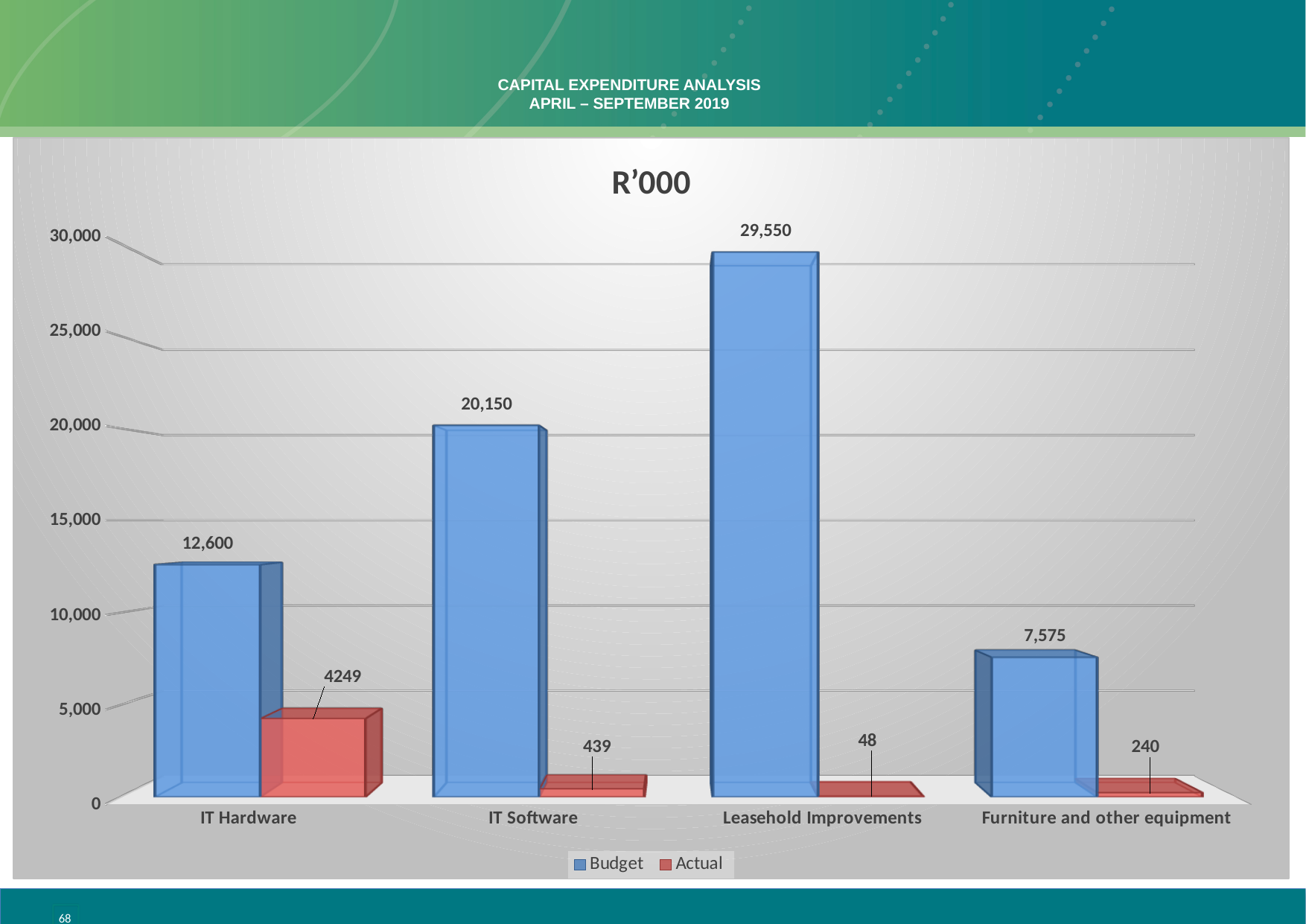
What is the Budget value for Leasehold Improvements? 29,550 Which is larger, the Budget value for IT Software or the Budget value for IT Hardware? IT Software What is the Budget value for Furniture and other equipment? 7,575 Which category has the lowest Actual value? Leasehold Improvements What is the Actual value for IT Software? 439 How many series does the legend list? 2 What kind of chart is shown on the slide? Bar chart Is the Budget value for IT Software greater or less than 20,000? greater How many categories are shown on the x axis? 4 What is the difference between the Budget and Actual values for IT Hardware? 8,351 What is the Actual value for IT Hardware? 4249 Which category has the highest Budget value? Leasehold Improvements